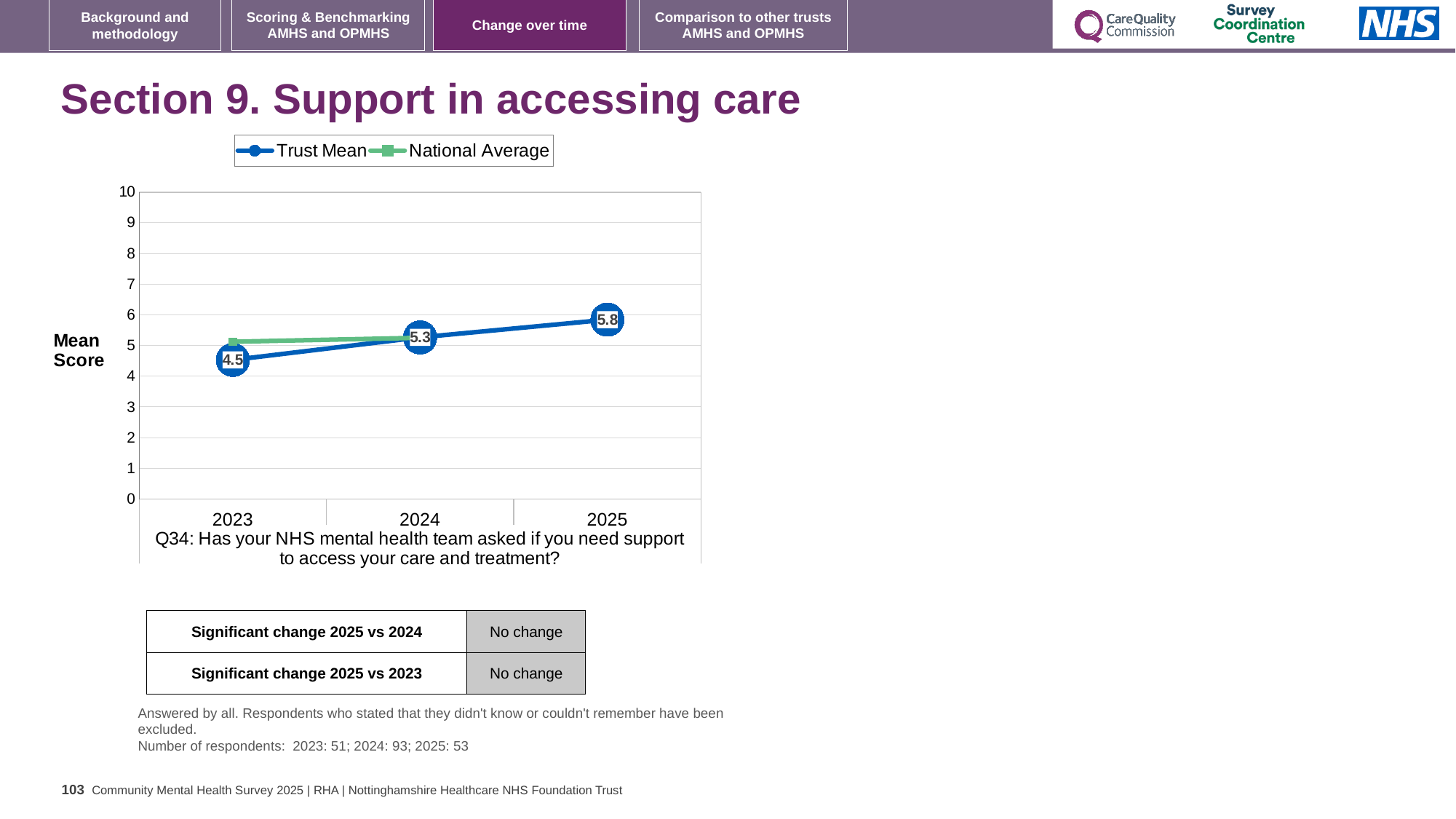
In which year is the Trust Mean highest? 2025 What kind of chart is shown on the slide? line chart What is the Trust Mean value for 2025? 5.8 What is the Trust Mean value for 2023? 4.5 What is the Trust Mean value for 2024? 5.3 How many series does the legend list? 2 How many years are shown on the x axis? 3 Which year has a larger Trust Mean, 2024 or 2025? 2025 Does the Trust Mean rise or fall from 2023 to 2025? rise Is the Trust Mean for 2023 greater or less than 5? less What is the difference between the Trust Mean in 2025 and in 2023? 1.3 In which year is the Trust Mean lowest? 2023